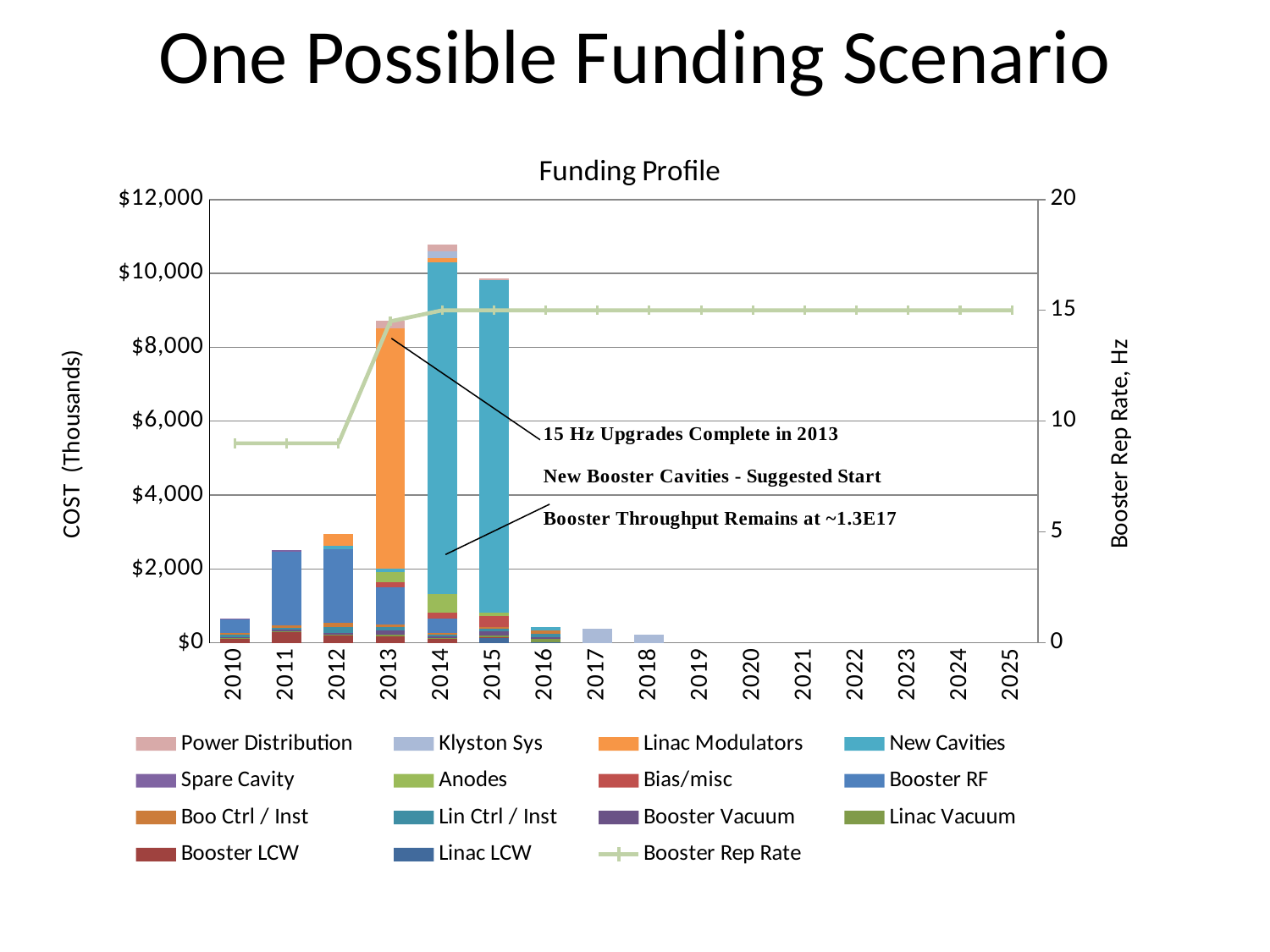
Is the Booster Rep Rate in 2010 greater or less than 10 Hz? less How many series does the legend list? 15 Is the total cost for 2014 greater or less than $10,000? greater Which year has the highest total cost bar? 2014 Is the total cost for 2011 greater or less than $2,000? greater Does the Booster Rep Rate line rise or fall between 2012 and 2013? rise What type of chart is shown on the slide? Stacked bar chart with a line What is the title of the chart? Funding Profile How many years are shown on the x axis of the chart? 16 Which year has the larger total cost bar, 2012 or 2013? 2013